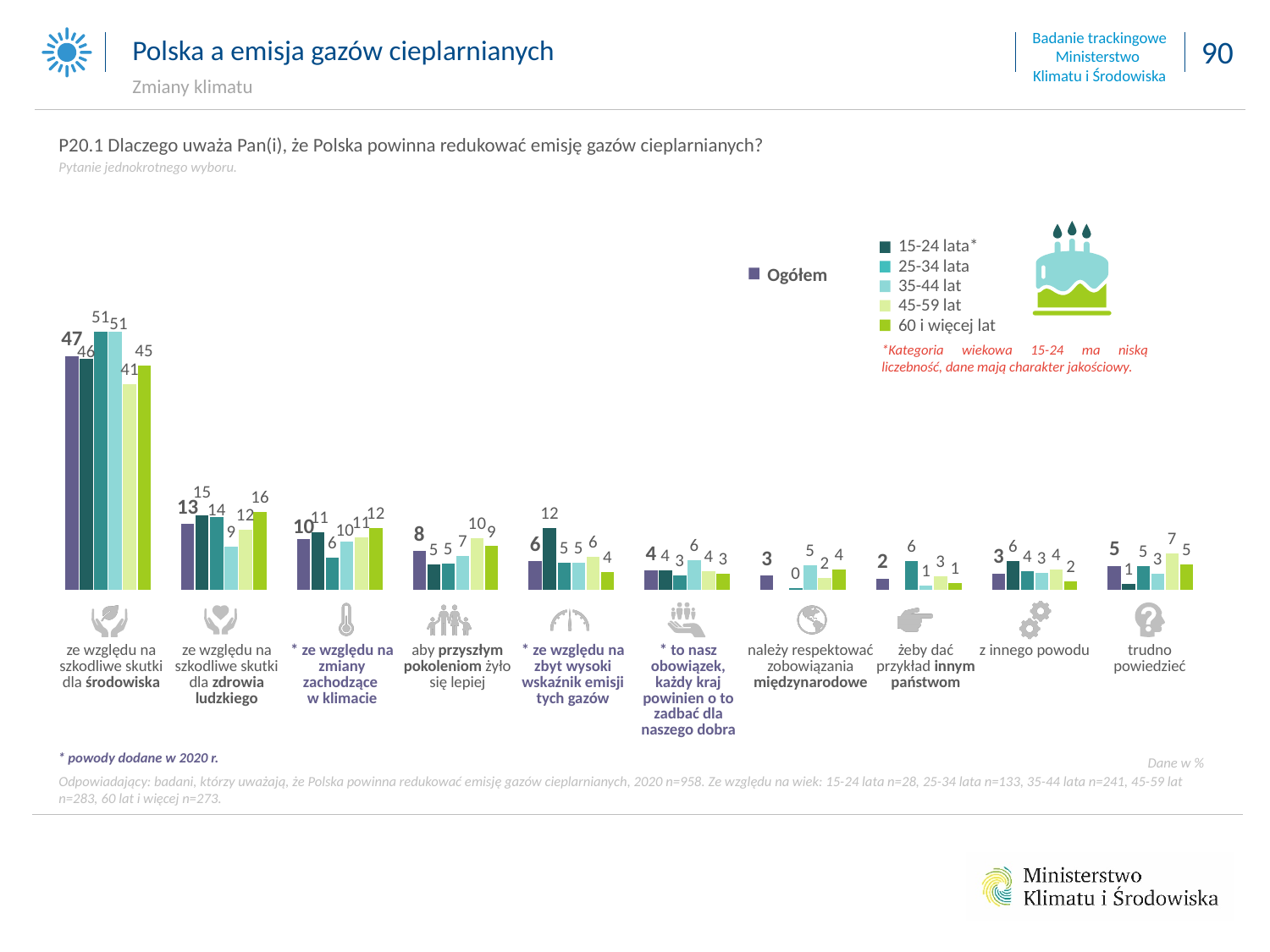
Which reason has the highest Ogółem value? ze względu na szkodliwe skutki dla środowiska How many reason categories are shown on the x axis? 10 In what unit are the data in the chart expressed, according to the note at the bottom right? % What kind of chart is shown on the slide? bar chart What is the value for the 60 i więcej lat group for 'ze względu na szkodliwe skutki dla zdrowia ludzkiego'? 16 What is the Ogółem (overall) value for 'ze względu na szkodliwe skutki dla środowiska'? 47 What is the difference between the Ogółem values for 'szkodliwe skutki dla środowiska' and 'szkodliwe skutki dla zdrowia ludzkiego'? 34 What is the Ogółem value for 'trudno powiedzieć'? 5 For 'ze względu na szkodliwe skutki dla środowiska', which group has the larger value: 25-34 lata or 45-59 lat? 25-34 lata How many series does the legend list (including Ogółem)? 6 Which reason has the lowest Ogółem value? żeby dać przykład innym państwom What is the value for the 15-24 lata group for 'ze względu na zbyt wysoki wskaźnik emisji tych gazów'? 12